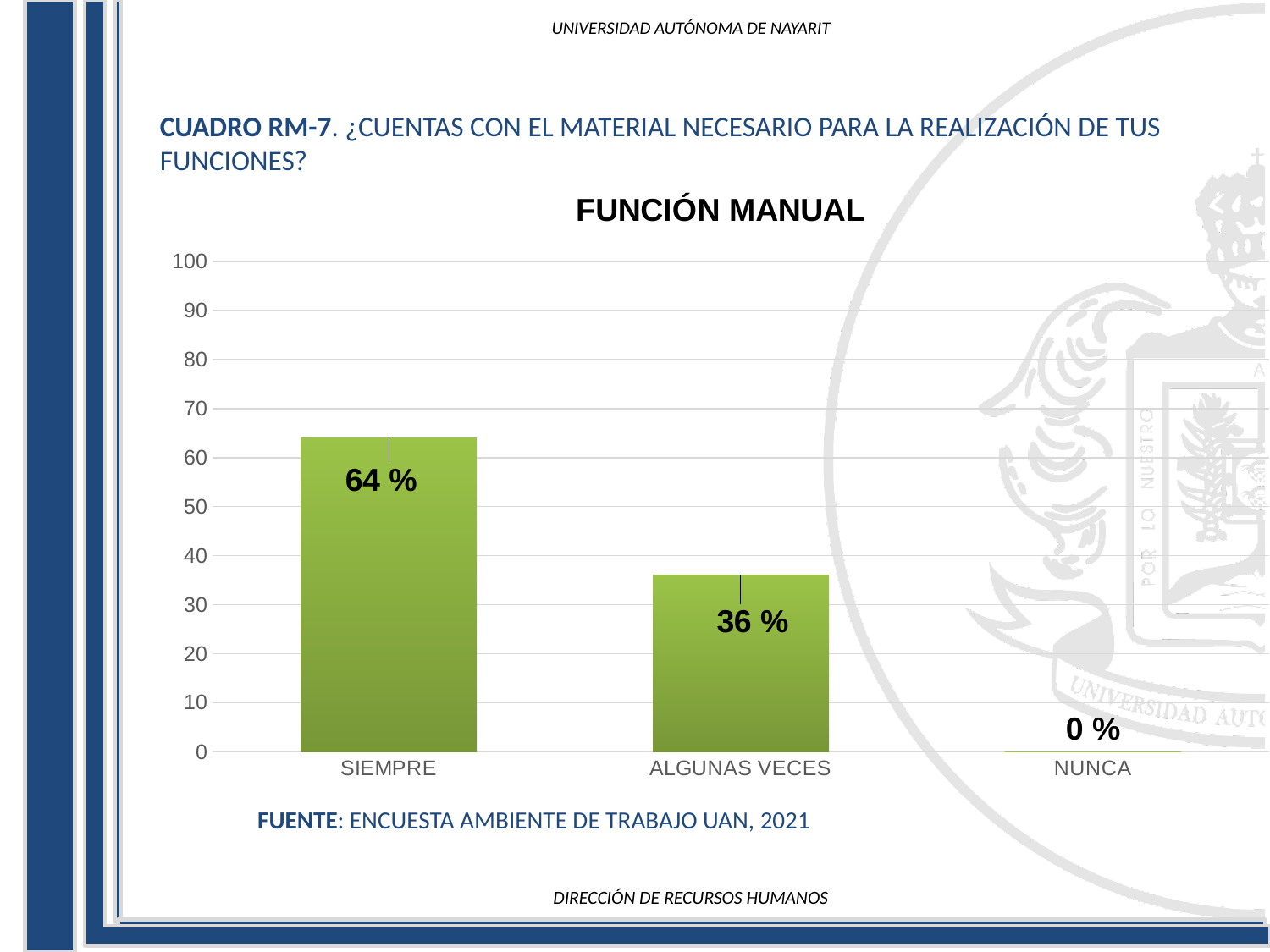
Is the value for ALGUNAS VECES greater or less than 40? less Is the value for SIEMPRE greater or less than 60? greater What is the value for NUNCA? 0 % What kind of chart is shown? bar chart How many categories are shown on the x axis? 3 Which is larger, the value for SIEMPRE or the value for ALGUNAS VECES? SIEMPRE What is the value for SIEMPRE? 64 % Which category has the lowest value? NUNCA What is the title of the chart? FUNCIÓN MANUAL What is the difference between the values for SIEMPRE and ALGUNAS VECES? 28 % What is the value for ALGUNAS VECES? 36 % Which category has the highest value? SIEMPRE